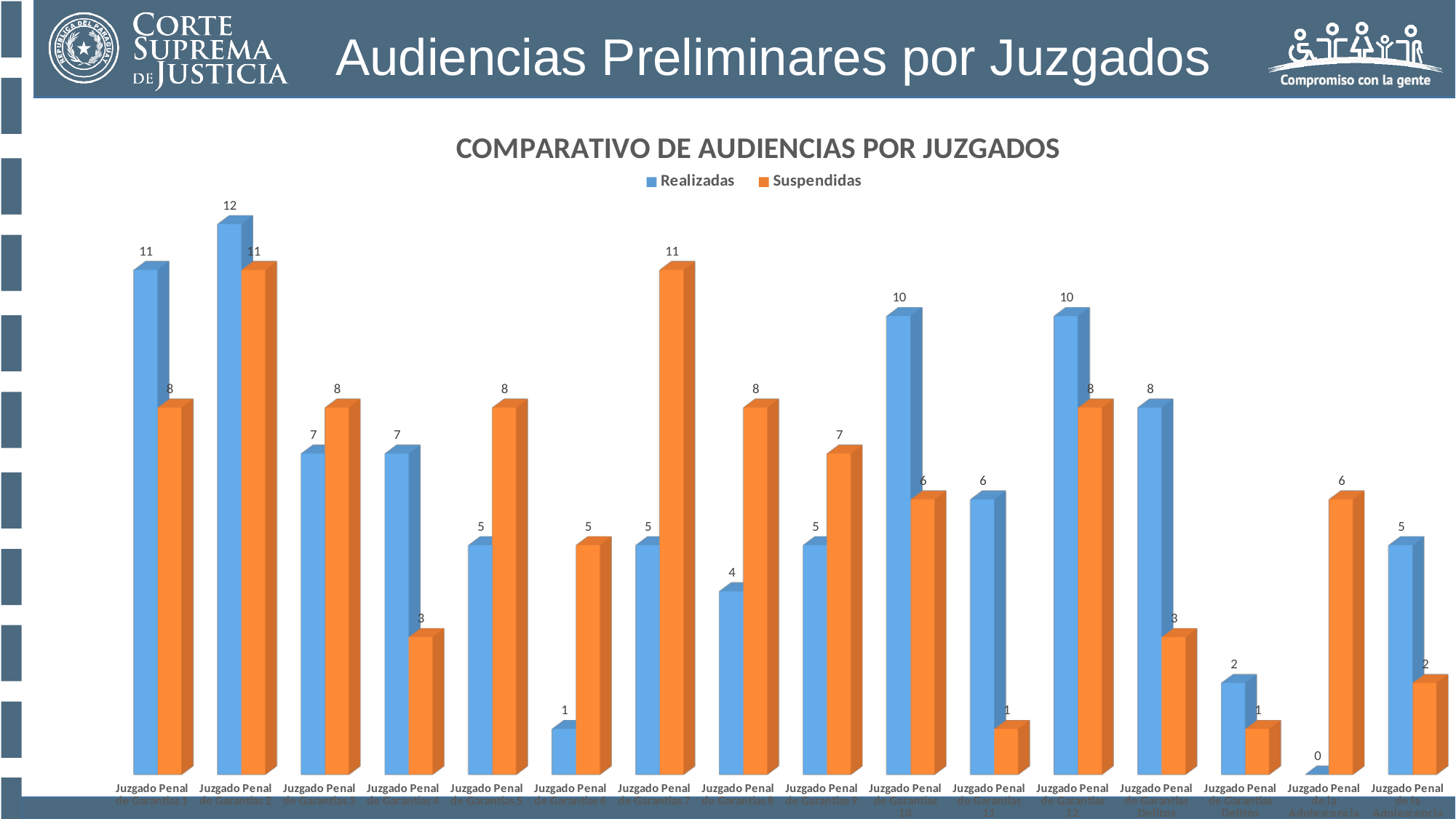
For Juzgado Penal de Garantías 5, which is larger: Realizadas or Suspendidas? Suspendidas What is the title of the chart? COMPARATIVO DE AUDIENCIAS POR JUZGADOS Which juzgado has the highest Realizadas value? Juzgado Penal de Garantías 2 How many Realizadas audiencias are shown for Juzgado Penal de Garantías 1? 11 What is the Suspendidas value for Juzgado Penal de Garantías 11? 1 Which has more Realizadas: Juzgado Penal de Garantías 1 or Juzgado Penal de Garantías 3? Juzgado Penal de Garantías 1 What is the difference between Realizadas and Suspendidas for Juzgado Penal de Garantías 10? 4 What is the difference between Realizadas and Suspendidas for Juzgado Penal de Garantías 4? 4 How many series does the legend list? 2 What kind of chart is shown on the slide? Bar chart What is the Realizadas value for Juzgado Penal de Garantías 6? 1 What is the Suspendidas value for Juzgado Penal de Garantías 7? 11